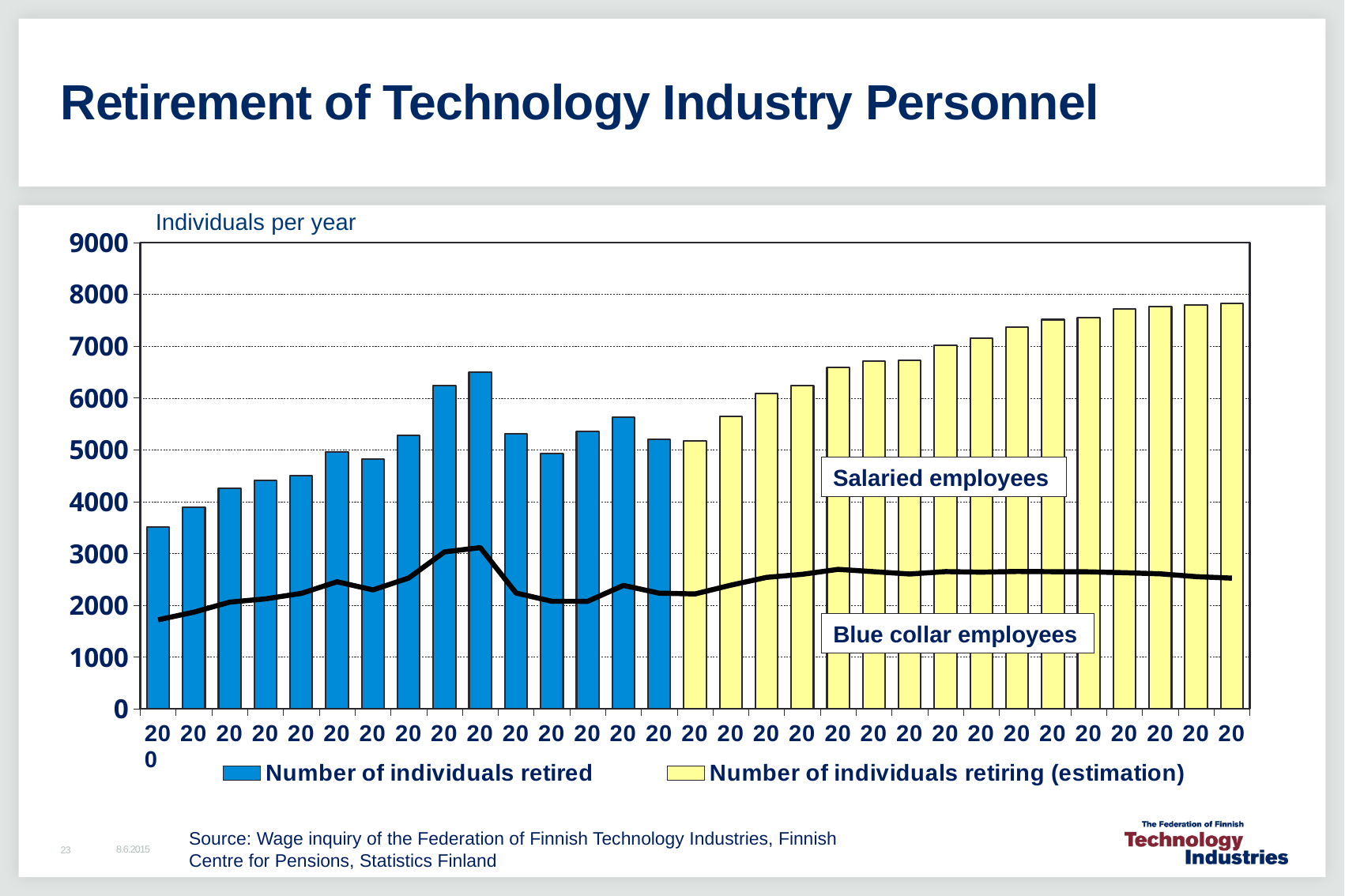
Is the value of the leftmost blue bar greater or less than 4000? less Which bar is the lowest in the chart: the leftmost bar or the rightmost bar? The leftmost bar What are the two series named in the legend? Number of individuals retired; Number of individuals retiring (estimation) What kind of chart is shown on the slide? Combination bar and line chart Which is larger: the rightmost yellow bar or the tallest blue bar? The rightmost yellow bar Is the value of the rightmost yellow bar greater or less than 8000? less Is the value of the leftmost blue bar greater or less than 3000? greater How many series does the legend list? 2 What is the label shown above the vertical axis? Individuals per year Do the yellow estimation bars rise or fall from left to right? Rise